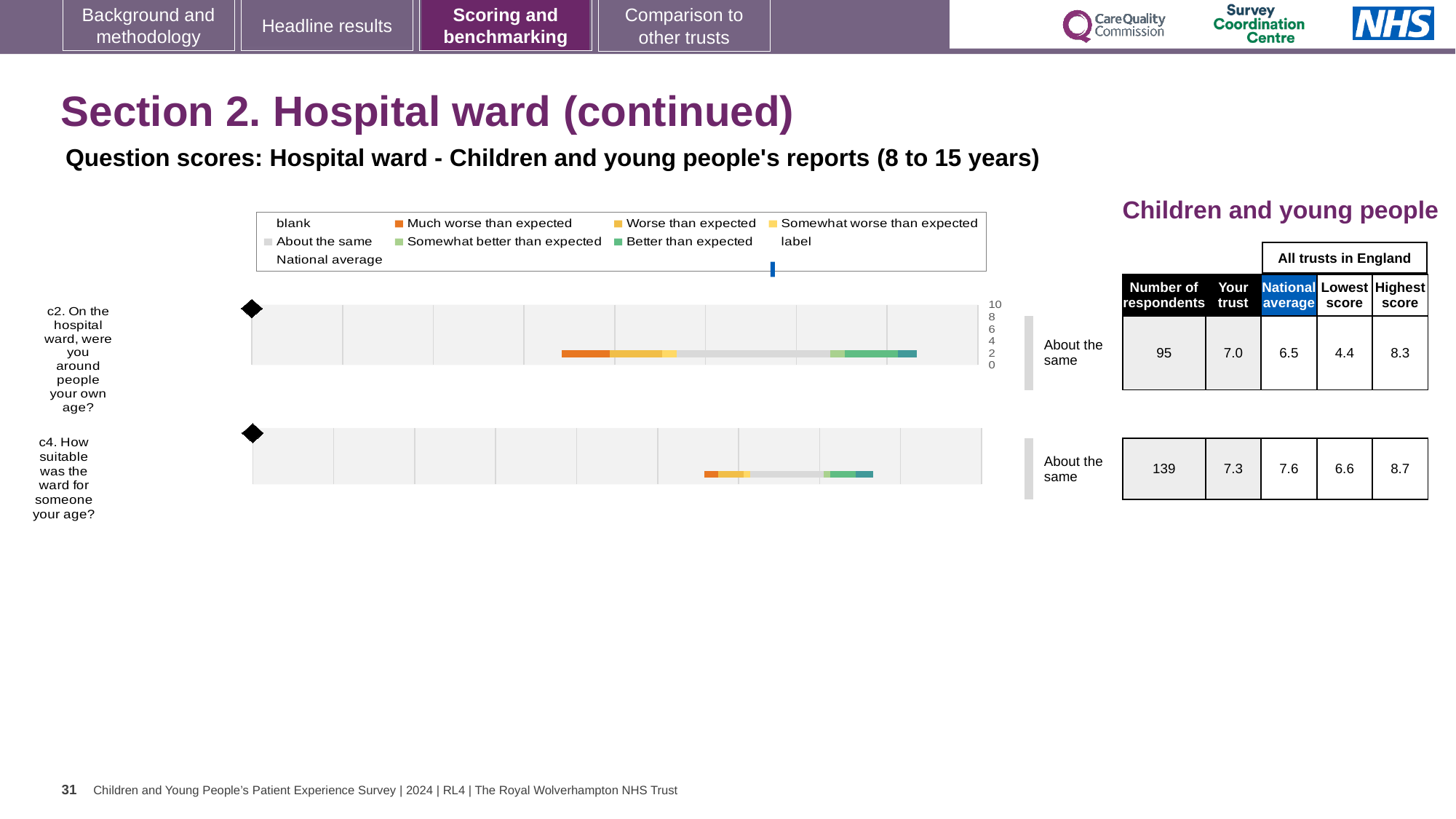
What is the highest score across all trusts in England for question c2? 8.3 How many respondents answered question c2? 95 What is the lowest score across all trusts in England for question c4? 6.6 What kind of chart is used to show the question scores on this slide? bar chart What is the difference between the trust's score and the national average for question c4? 0.3 What benchmark category is shown for question c2? About the same What is the difference between the highest and lowest scores for question c2? 3.9 What is the national average score for question c4 (How suitable was the ward for someone your age?)? 7.6 For question c4, is the trust's score higher or lower than the national average? lower How many questions (categories) are plotted in the chart? 2 What is the trust's score for question c2 (On the hospital ward, were you around people your own age?)? 7.0 Which question has the higher trust score, c2 or c4? c4